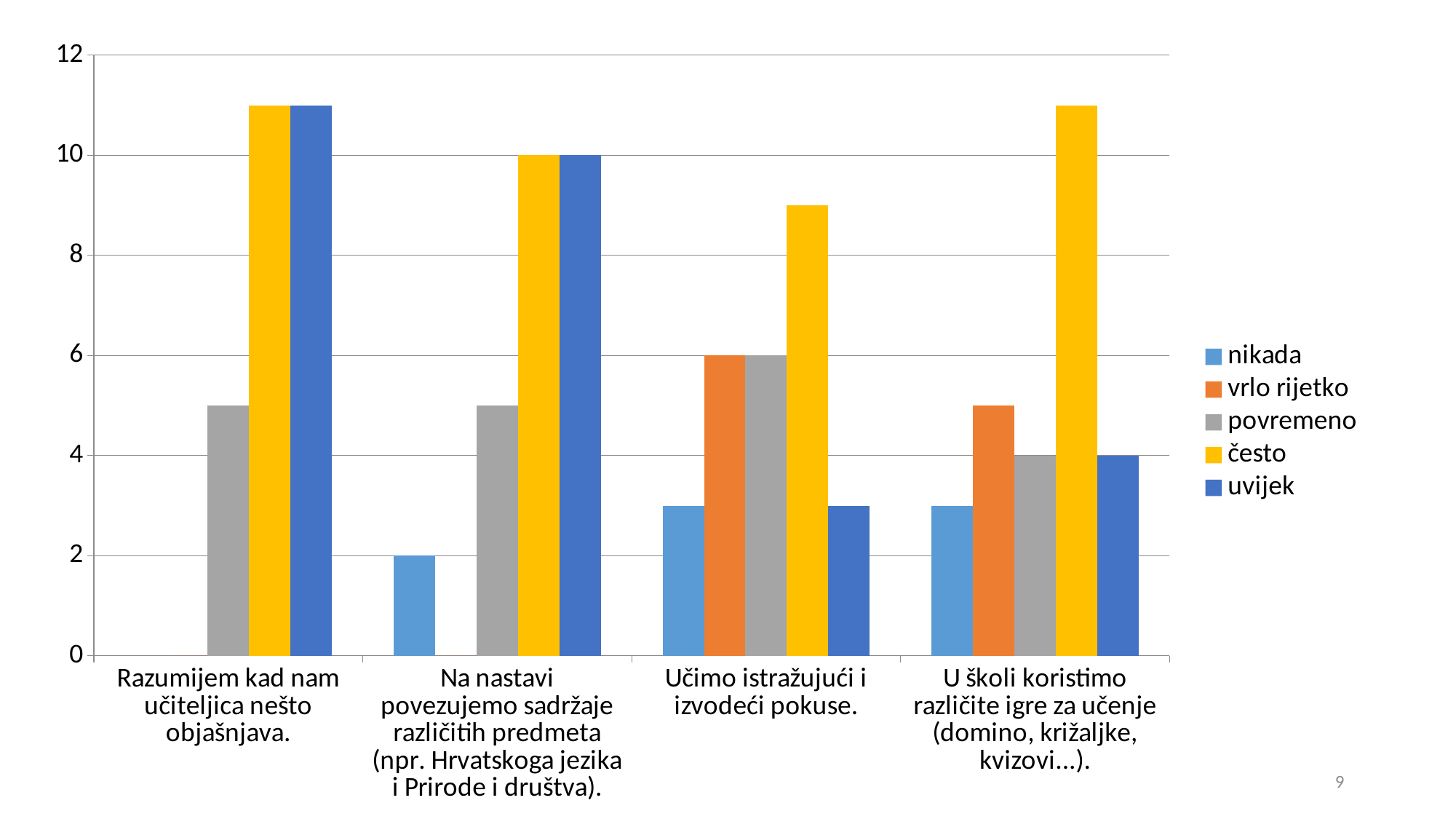
What is the value of "često" for the category "Na nastavi povezujemo sadržaje različitih predmeta"? 10 For the category "Učimo istražujući i izvodeći pokuse.", which is larger: "često" or "uvijek"? često What kind of chart is shown on the slide? Bar chart Which series has the lowest value for the category "U školi koristimo različite igre za učenje"? nikada What is the value of "uvijek" for the category "U školi koristimo različite igre za učenje"? 4 How many series does the legend list? 5 What is the value of "nikada" for the category "Na nastavi povezujemo sadržaje različitih predmeta"? 2 What is the value of "vrlo rijetko" for the category "Učimo istražujući i izvodeći pokuse."? 6 Which series has the highest value for the category "U školi koristimo različite igre za učenje"? često Is the value of "često" for "Učimo istražujući i izvodeći pokuse." greater or less than 8? greater What is the difference between "često" and "nikada" for the category "Na nastavi povezujemo sadržaje različitih predmeta"? 8 Is the value of "često" for "Razumijem kad nam učiteljica nešto objašnjava." greater or less than 10? greater